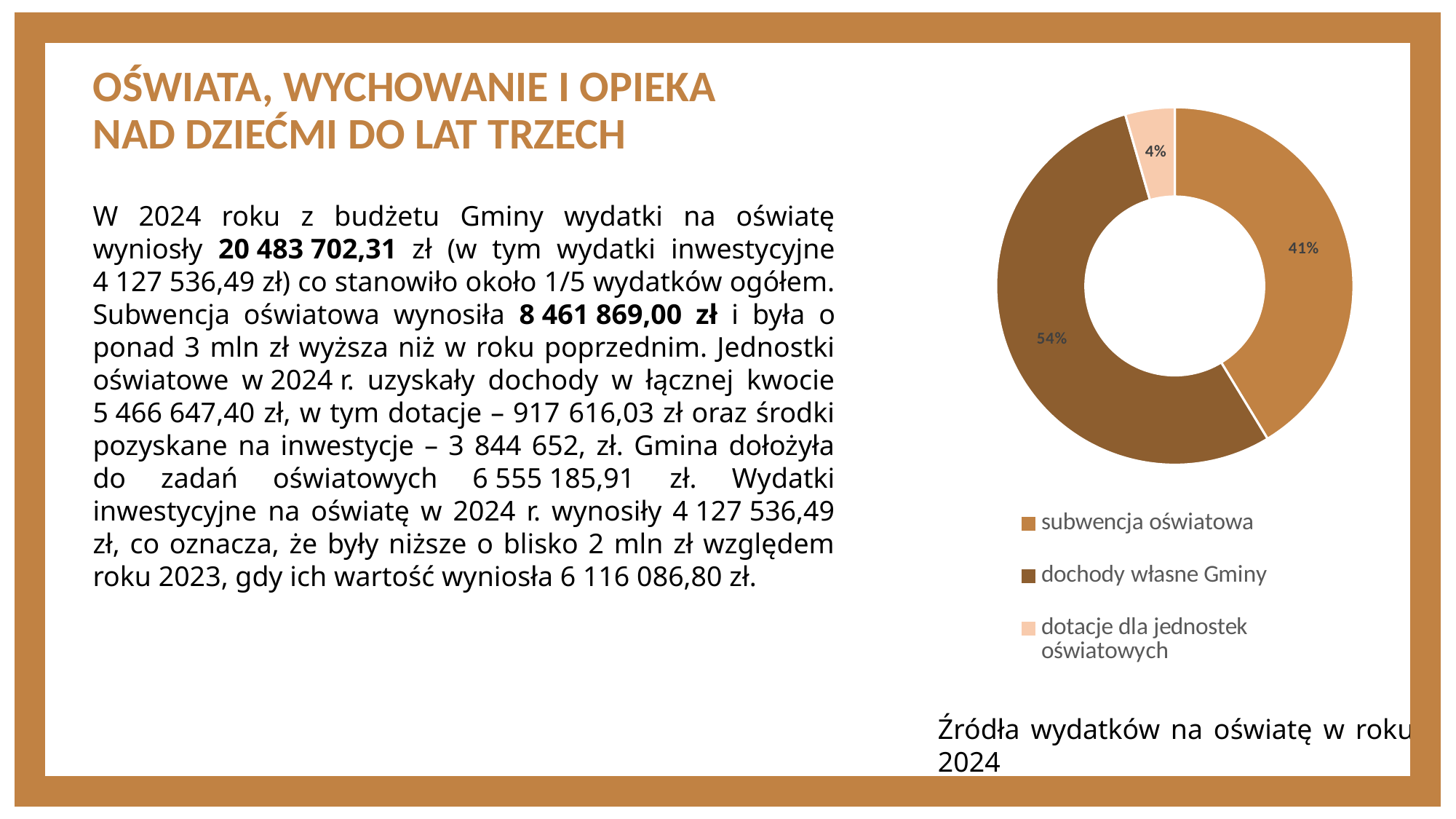
What is the title of the chart? Źródła wydatków na oświatę w roku 2024 What share of the chart does 'dotacje dla jednostek oświatowych' represent? 4% What share of the chart does 'subwencja oświatowa' represent? 41% What kind of chart is shown on the slide? doughnut (pie) chart Which is larger: the share for 'subwencja oświatowa' or for 'dotacje dla jednostek oświatowych'? subwencja oświatowa Which category has the smallest share in the chart? dotacje dla jednostek oświatowych Which legend entry is shown in the lightest colour? dotacje dla jednostek oświatowych What is the difference in percentage points between 'dochody własne Gminy' and 'subwencja oświatowa'? 13 What share of the chart does 'dochody własne Gminy' represent? 54% How many categories does the chart show? 3 Which category has the largest share in the chart? dochody własne Gminy